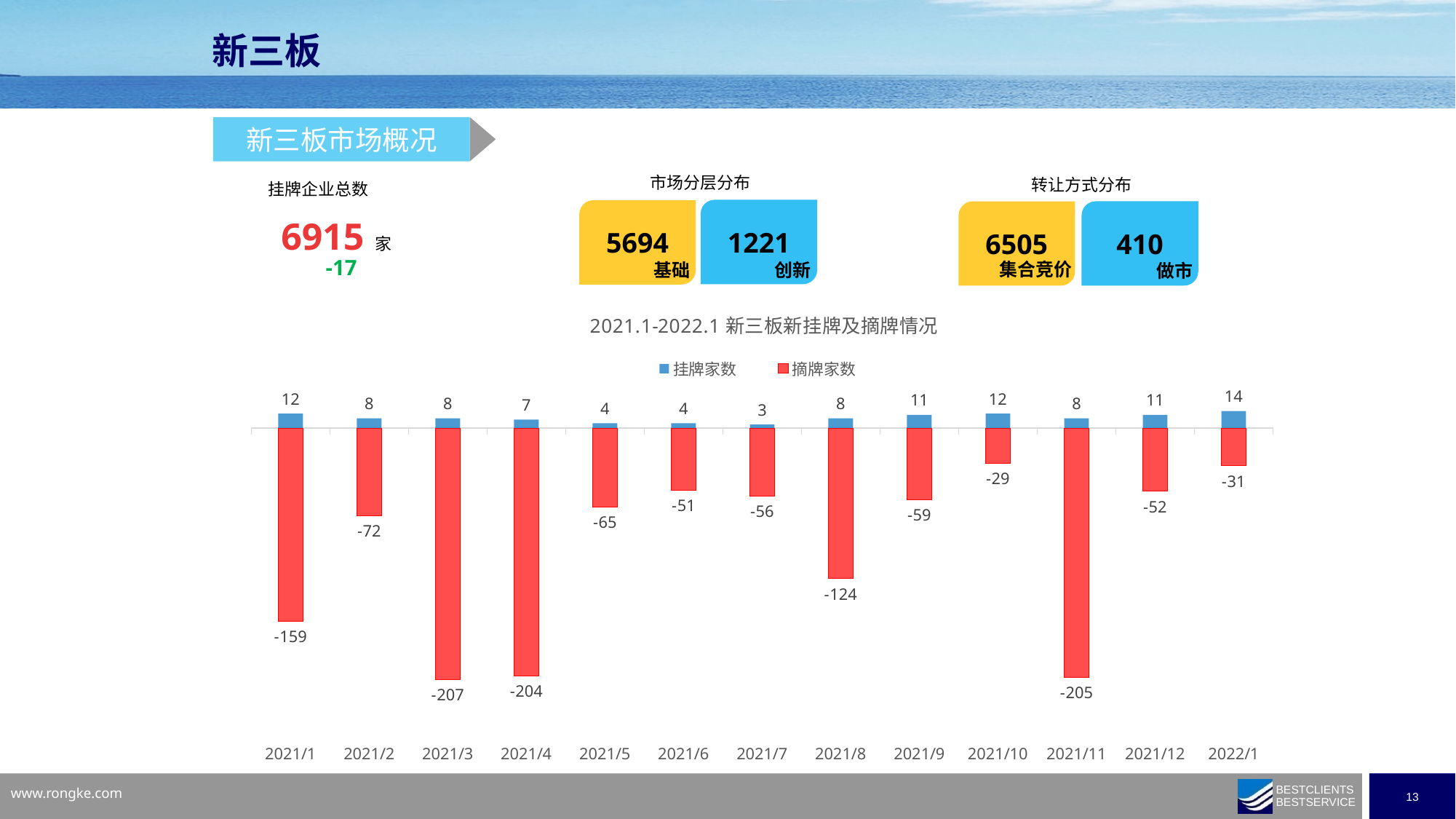
Which month has the smallest 摘牌家数 in magnitude (closest to zero)? 2021/10 What is the difference between the 挂牌家数 for 2021/1 and 2021/5? 8 How many months are shown on the x axis of the chart? 13 Which month has the lowest 挂牌家数? 2021/7 What type of chart is used to show 新挂牌及摘牌情况? Bar chart What is the 摘牌家数 value for 2021/8? -124 Which is larger in magnitude, the 摘牌家数 for 2021/4 or for 2021/11? 2021/11 What is the 挂牌家数 value for 2022/1? 14 How many series does the chart legend list? 2 Which colour represents 摘牌家数 in the chart? Red Which month has the highest 挂牌家数? 2022/1 What is the 摘牌家数 value for 2021/3? -207